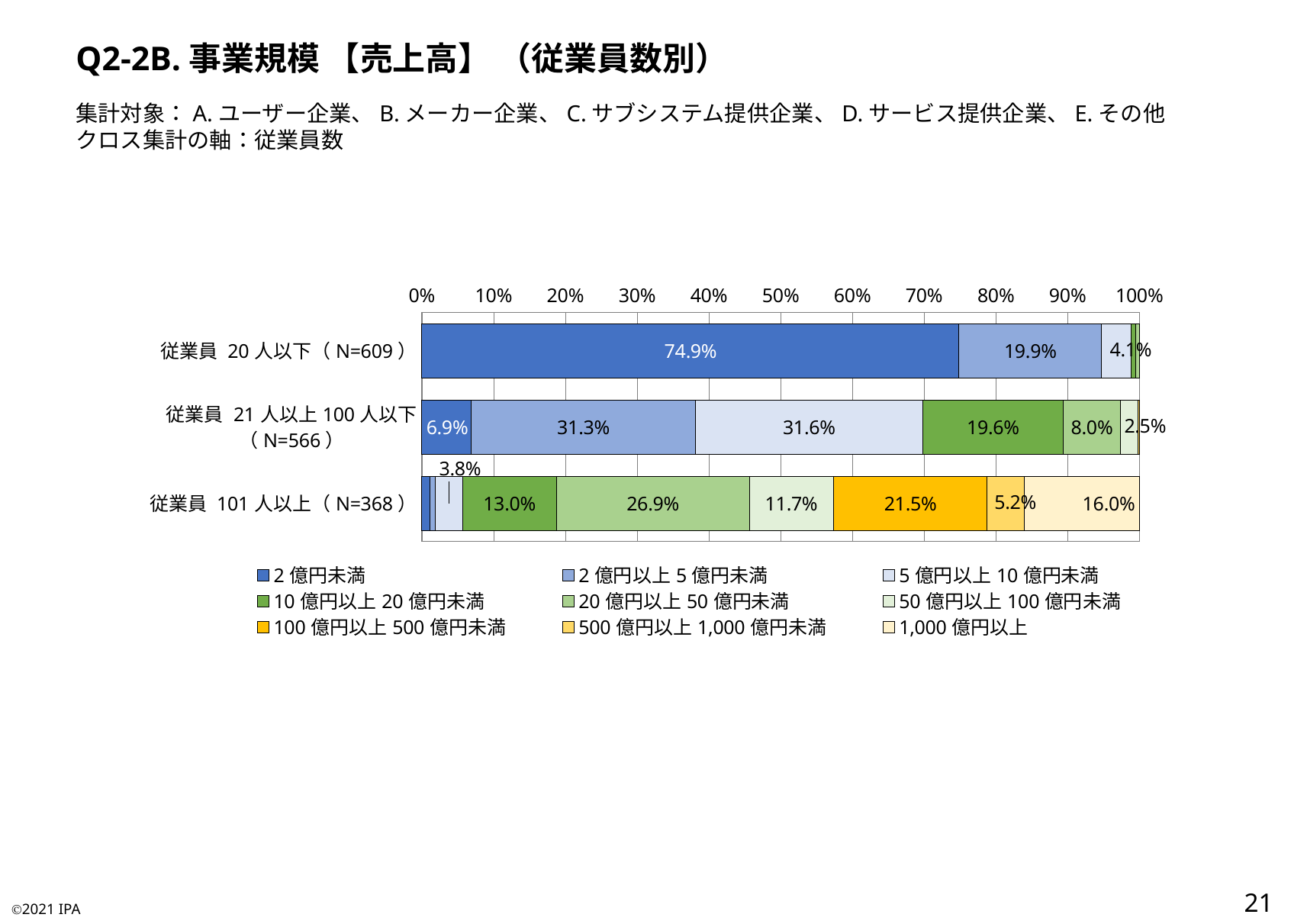
Which employee-size category has the largest share of 2億円未満? 従業員 20人以下 (N=609) For 従業員 101人以上, which is larger: the share of 100億円以上500億円未満 or the share of 10億円以上20億円未満? 100億円以上500億円未満 What is the share of 1,000億円以上 for 従業員 101人以上 (N=368)? 16.0% What is the share of 5億円以上10億円未満 for 従業員 21人以上100人以下 (N=566)? 31.6% What is the share of 20億円以上50億円未満 for 従業員 101人以上 (N=368)? 26.9% Is the share of 2億円未満 for 従業員 101人以上 greater or less than 10%? less How many employee-size categories are plotted in the chart? 3 What kind of chart is shown on the slide? Stacked bar chart What is the share of 10億円以上20億円未満 for 従業員 21人以上100人以下 (N=566)? 19.6% How many series does the legend list? 9 For 従業員 20人以下, what is the difference in percentage points between the 2億円未満 share (74.9%) and the 2億円以上5億円未満 share (19.9%)? 55.0 percentage points What is the share of 2億円未満 for 従業員 20人以下 (N=609)? 74.9%